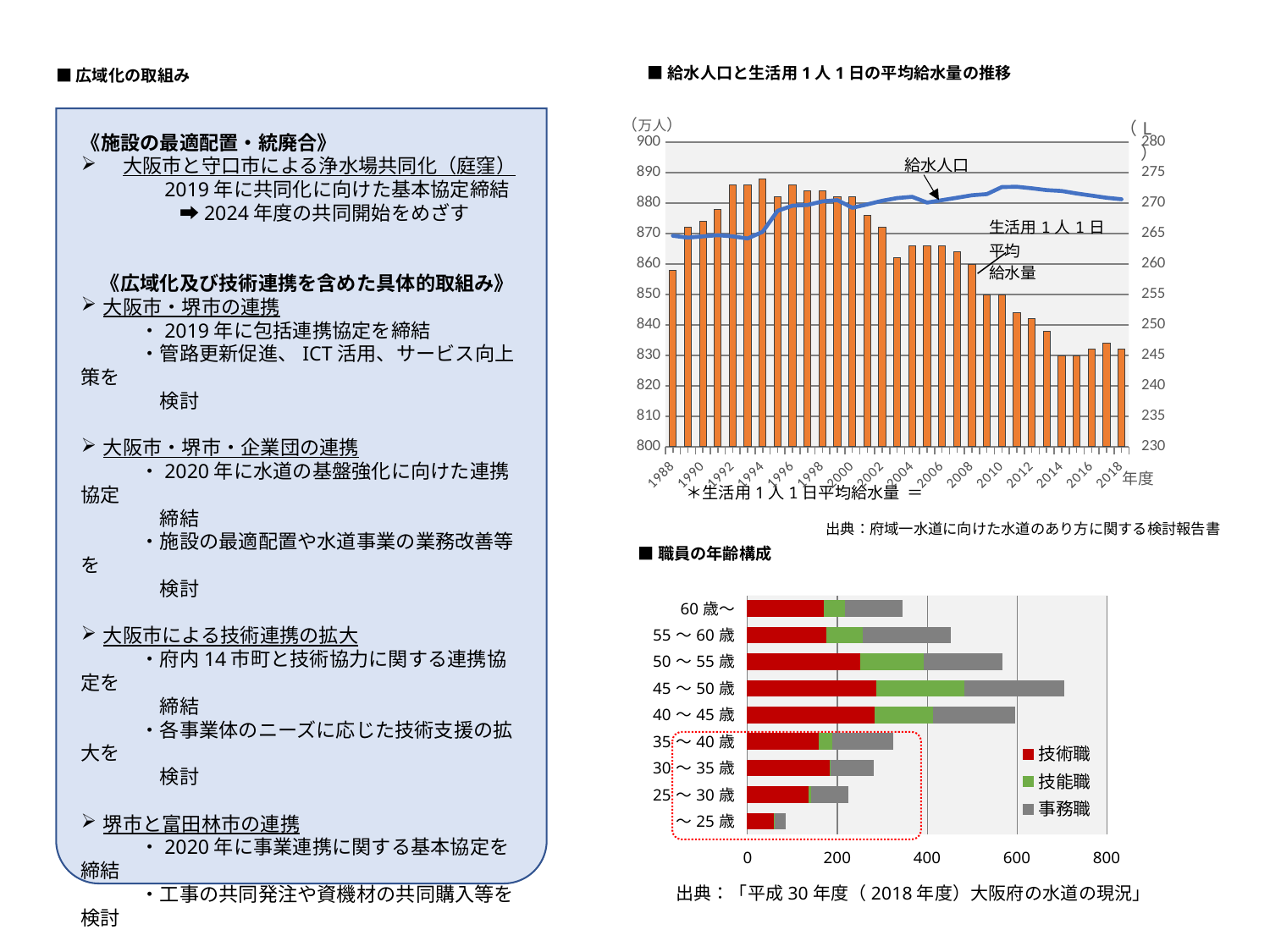
In the top-right chart titled 給水人口と生活用1人1日の平均給水量の推移, do the bars for 生活用1人1日平均給水量 generally rise or fall from 1988 to 2018? fall In the bottom-right chart titled 職員の年齢構成, which age category has the longest total bar? 45〜50歳 In the bottom-right chart titled 職員の年齢構成, what kind of chart is it? bar chart In the top-right chart titled 給水人口と生活用1人1日の平均給水量の推移, is the bar value for 2018 greater or less than 250 on the right axis? less In the bottom-right chart titled 職員の年齢構成, which age category has the shortest total bar? 〜25歳 In the bottom-right chart titled 職員の年齢構成, which colour represents 技術職 in the legend? red In the top-right chart titled 給水人口と生活用1人1日の平均給水量の推移, is the 給水人口 line value for 1988 greater or less than 880 on the left axis? less In the bottom-right chart titled 職員の年齢構成, how many series does the legend list? 3 In the top-right chart titled 給水人口と生活用1人1日の平均給水量の推移, what kind of chart is used to show the 生活用1人1日平均給水量 series? bar chart In the top-right chart titled 給水人口と生活用1人1日の平均給水量の推移, is the bar value for 1994 greater or less than 270 on the right axis? greater In the top-right chart titled 給水人口と生活用1人1日の平均給水量の推移, how many bars are plotted (one per year from 1988 to 2018)? 31 In the bottom-right chart titled 職員の年齢構成, how many age categories are shown? 9